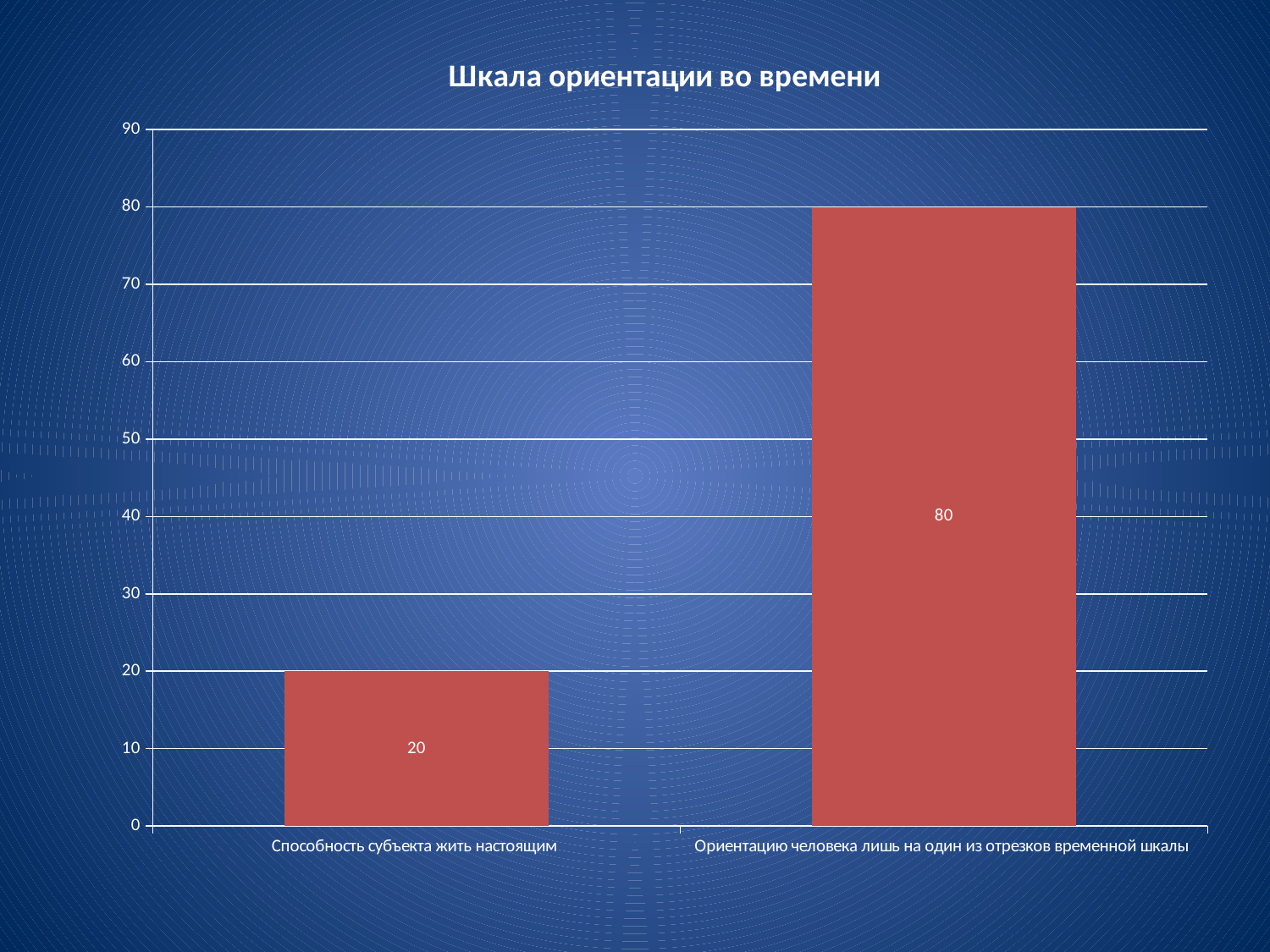
What is the difference between the values for "Ориентацию человека лишь на один из отрезков временной шкалы" and "Способность субъекта жить настоящим"? 60 How many categories are shown on the chart? 2 What is the title of the chart? Шкала ориентации во времени What kind of chart is shown on the slide? bar chart Is the value for "Ориентацию человека лишь на один из отрезков временной шкалы" greater or less than 50? greater What is the value for "Ориентацию человека лишь на один из отрезков временной шкалы"? 80 What is the value for "Способность субъекта жить настоящим"? 20 Is the value for "Способность субъекта жить настоящим" greater or less than 30? less Which category has the lowest value? Способность субъекта жить настоящим Which is larger: the value for "Способность субъекта жить настоящим" or the value for "Ориентацию человека лишь на один из отрезков временной шкалы"? Ориентацию человека лишь на один из отрезков временной шкалы What is the highest value shown on the vertical axis? 90 Which category has the highest value? Ориентацию человека лишь на один из отрезков временной шкалы